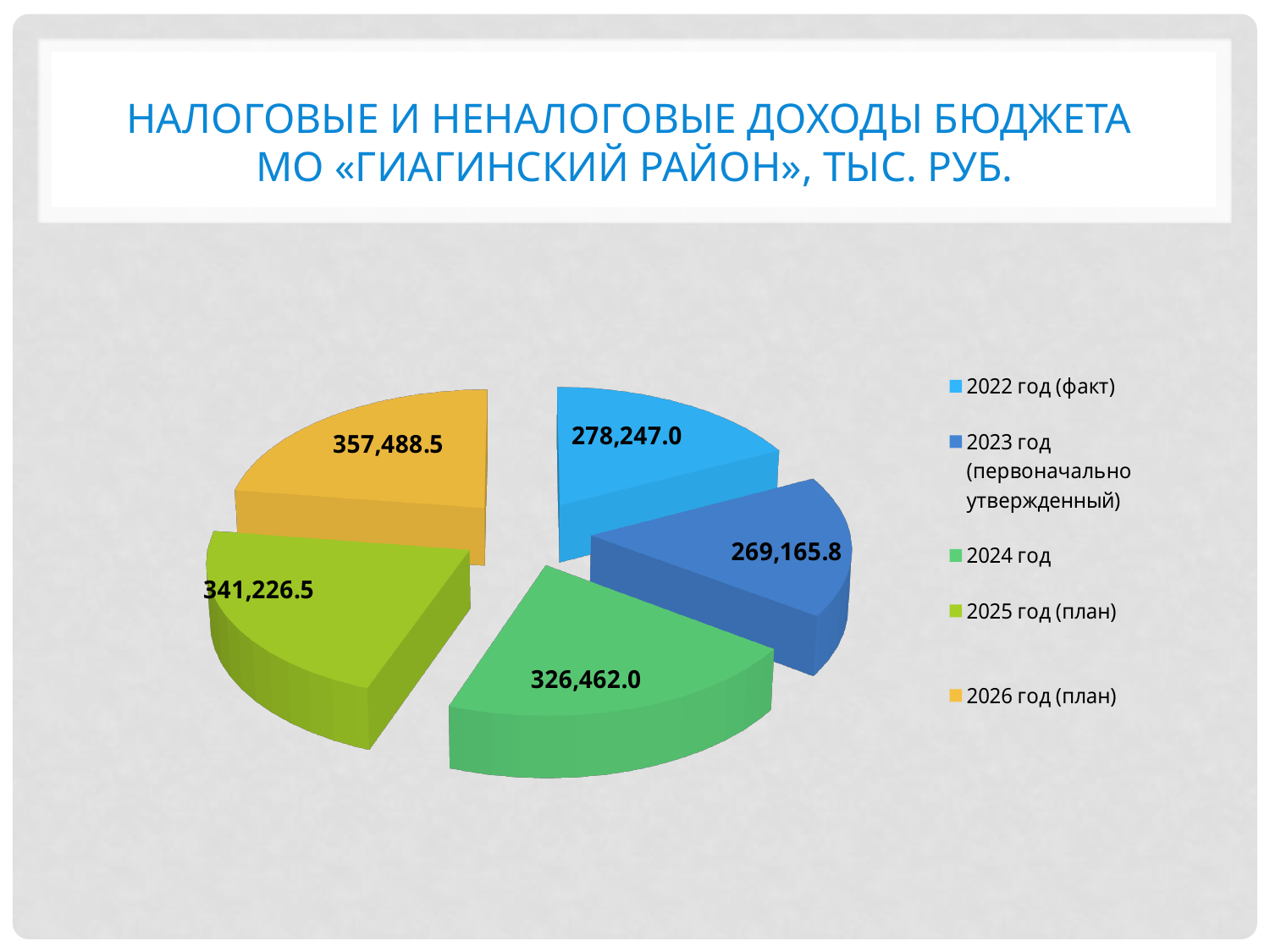
What is the value for 2023 год (первоначально утвержденный)? 269,165.8 What is the value for 2024 год? 326,462.0 Which is larger: the value for 2022 год (факт) or 2023 год (первоначально утвержденный)? 2022 год (факт) What colour is the slice for 2026 год (план)? Orange/yellow What is the value for 2026 год (план)? 357,488.5 What is the value for 2022 год (факт)? 278,247.0 Which year has the highest value in the pie chart? 2026 год (план) What type of chart is shown on the slide? Pie chart What is the value for 2025 год (план)? 341,226.5 How many slices does the pie chart have? 5 Which year has the lowest value in the pie chart? 2023 год (первоначально утвержденный) What is the difference between the values for 2026 год (план) and 2022 год (факт)? 79,241.5